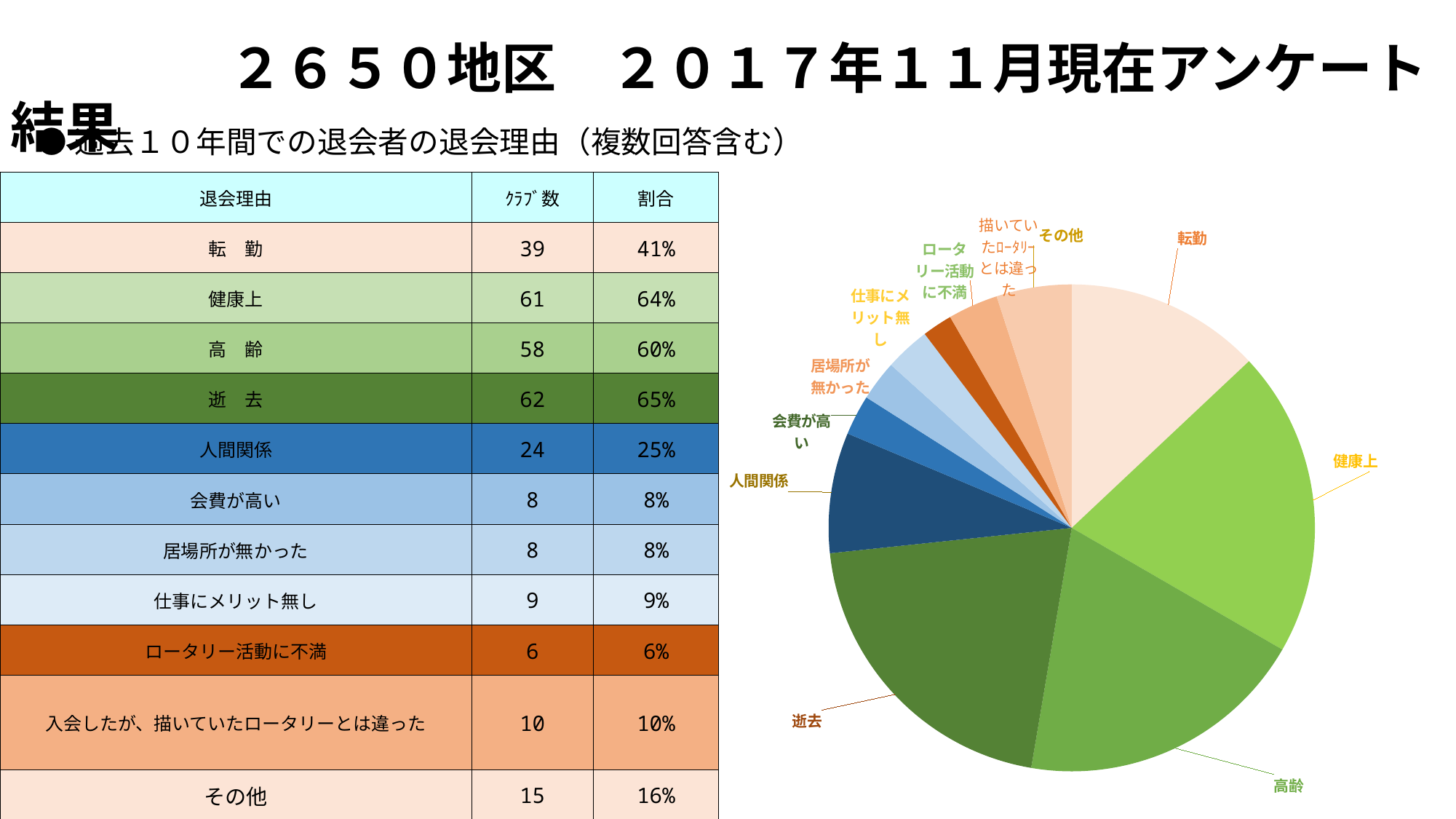
Using the table values, what is the difference in クラブ数 between 健康上 and 人間関係? 37 How many slices (categories) does the pie chart have? 11 According to the table, what is the クラブ数 for その他? 15 According to the table, how many clubs cited 人間関係? 24 According to the table, what is the 割合 for 逝去? 65% According to the table, how many clubs (クラブ数) cited 転勤 as a reason for leaving? 39 In the pie chart, which slice is larger: 健康上 or 会費が高い? 健康上 In the pie chart, which slice is larger: 転勤 or 人間関係? 転勤 What colour is the 健康上 slice in the pie chart? light green What kind of chart is shown on the right side of the slide? pie chart Which category in the table has the highest クラブ数? 逝去 In the pie chart, which slice is larger: その他 or ロータリー活動に不満? その他